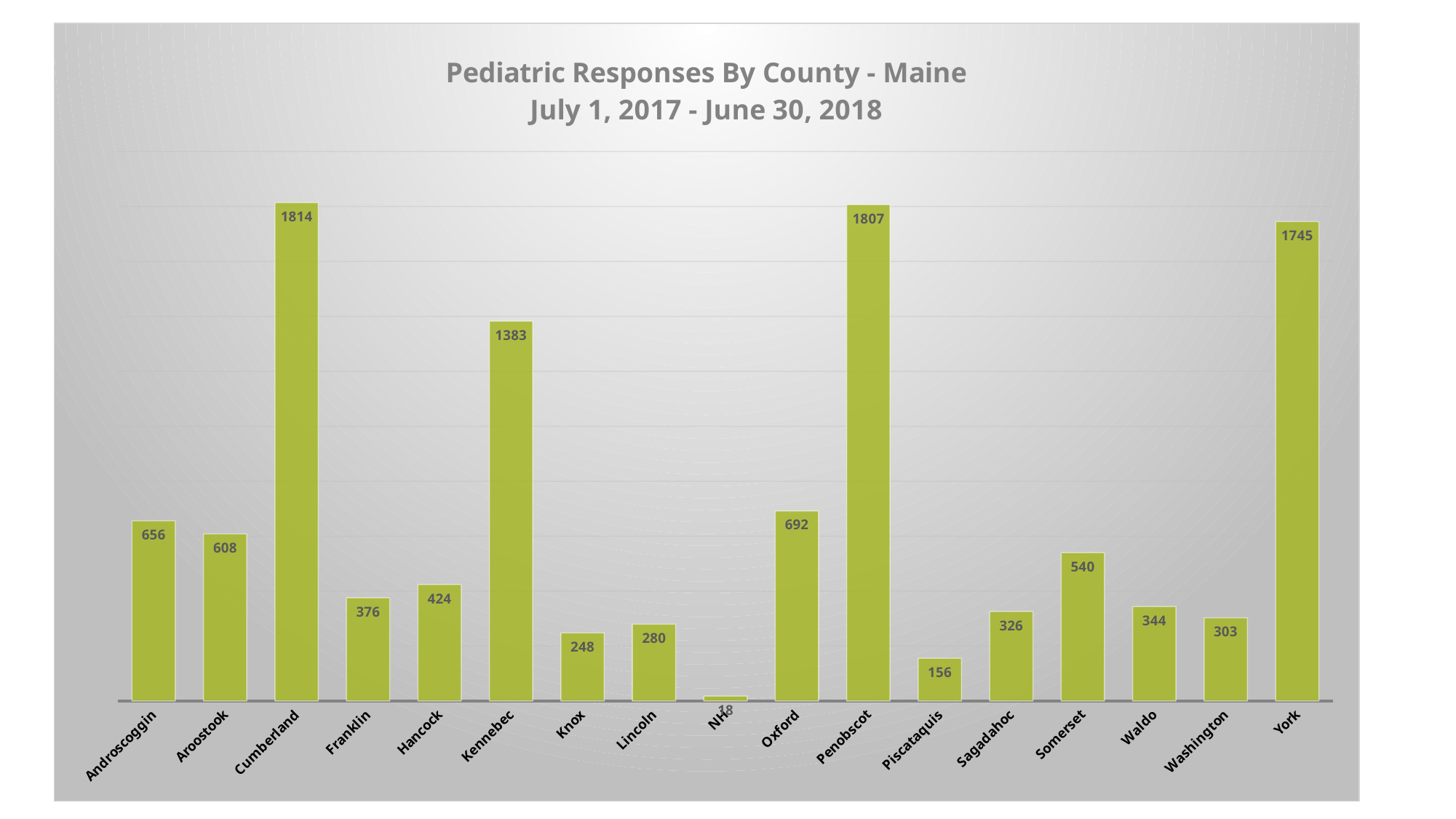
What is the value for Kennebec? 1383 What type of chart is shown on the slide? Bar chart How many counties (categories) are shown in the chart? 17 Which county has the highest value? Cumberland Which category has the lowest value? NH What is the difference between the values for York and Kennebec? 362 What is the difference between the values for Cumberland and Penobscot? 7 What is the title of the chart? Pediatric Responses By County - Maine July 1, 2017 - June 30, 2018 What is the value for Somerset? 540 What is the value for Piscataquis? 156 Which has a larger value, Oxford or Androscoggin? Oxford What is the value for Cumberland? 1814